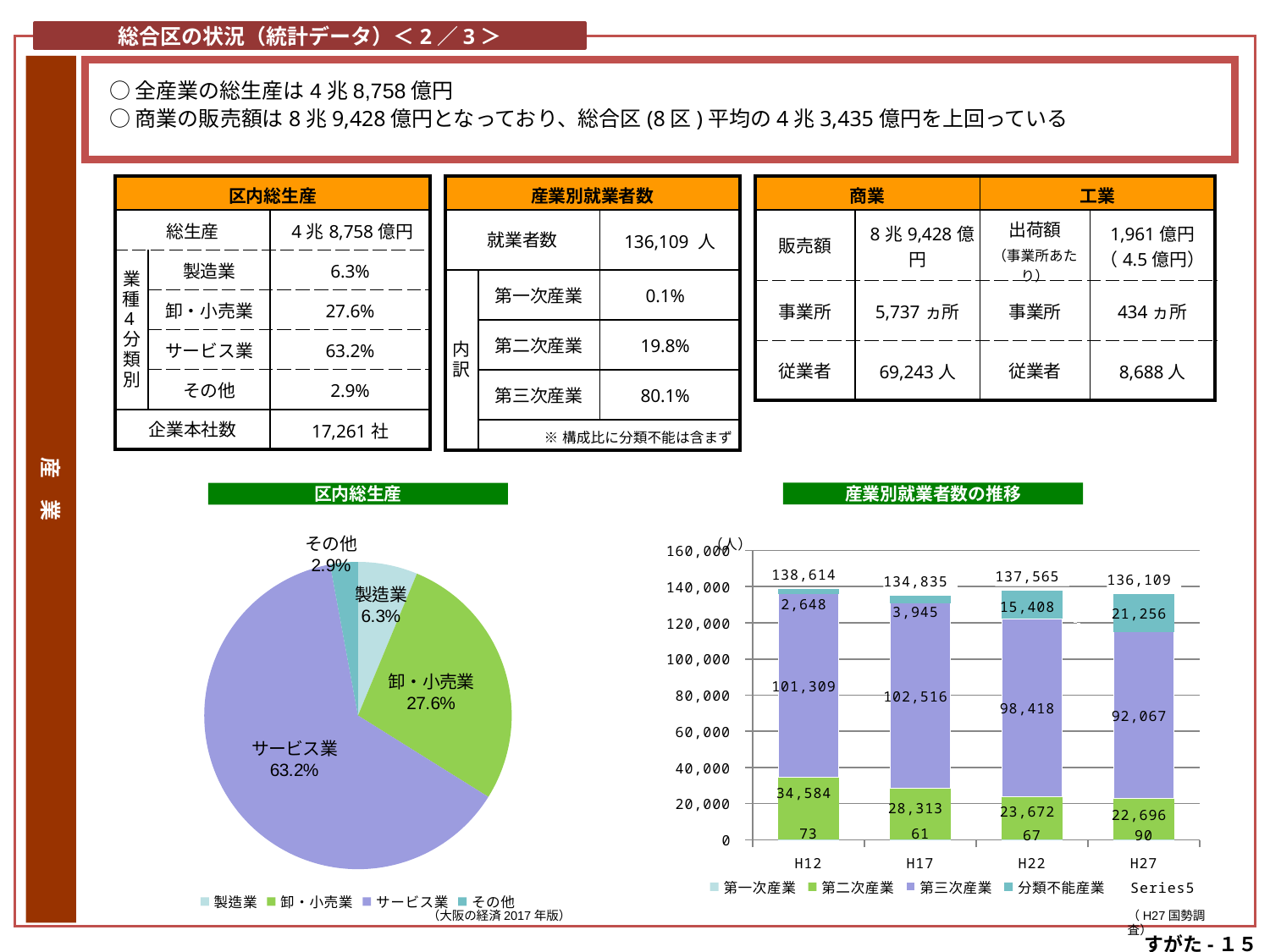
In the 区内総生産 pie chart, what share does サービス業 have? 63.2% In the 産業別就業者数の推移 chart, what is the difference between the 第二次産業 values for H12 and H27? 11,888 In the 産業別就業者数の推移 chart, does the 第二次産業 value rise or fall from H12 to H27? fall In the 産業別就業者数の推移 chart, what is the total of the stacked bar for H22? 137,565 In the 産業別就業者数の推移 chart, what is the value for 第三次産業 in H17? 102,516 In the 産業別就業者数の推移 chart, which year has the highest total? H12 In the 産業別就業者数の推移 chart, is the 分類不能産業 value larger in H22 or H27? H27 In the 区内総生産 pie chart, which category has the smallest share? その他 What kind of chart is the 区内総生産 chart? pie chart In the 区内総生産 pie chart, what is the value for 卸・小売業? 27.6% In the 産業別就業者数の推移 chart, how many series does the legend list? 5 In the 区内総生産 pie chart, how many categories are shown? 4